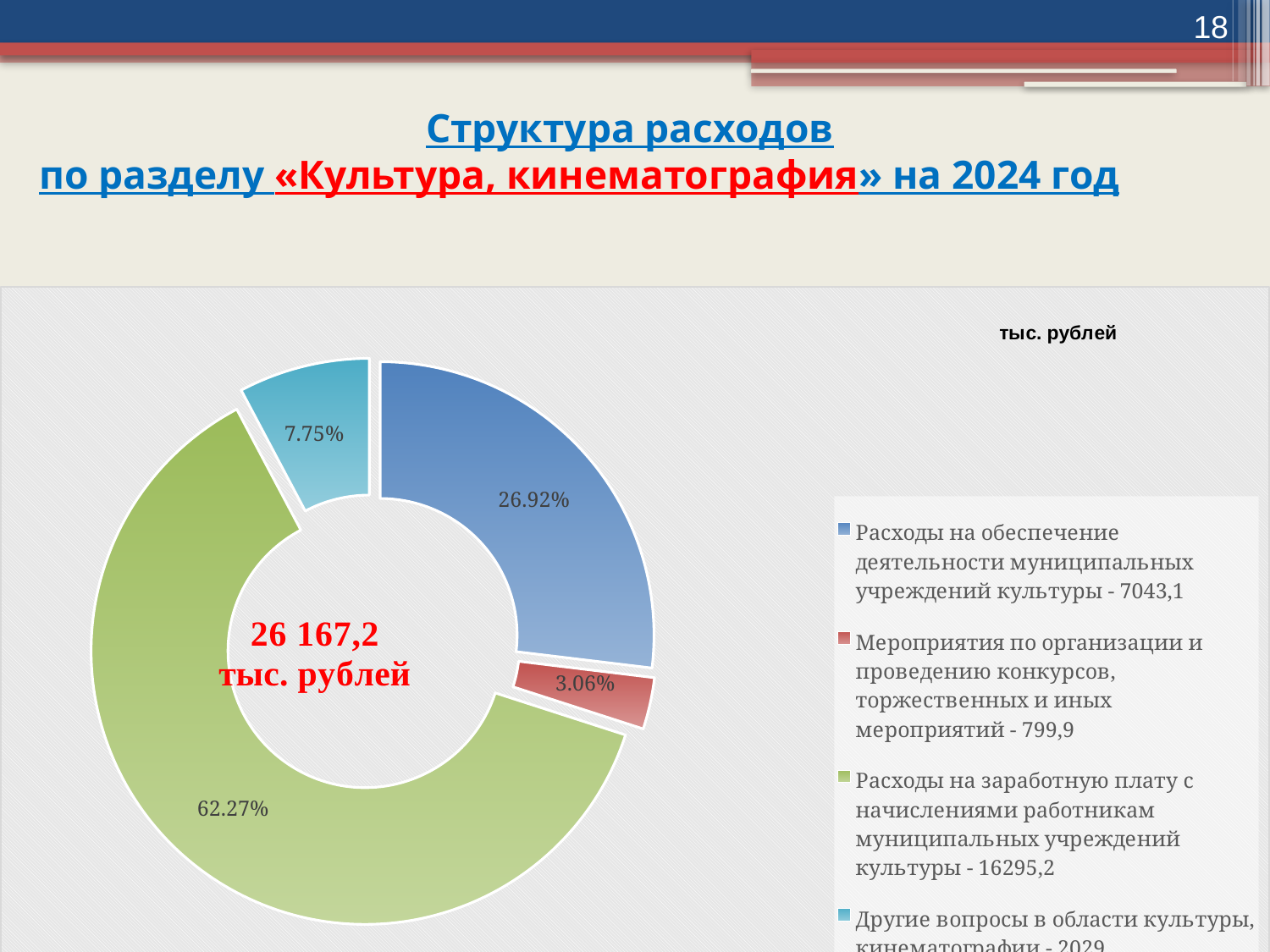
How many slices does the doughnut chart have? 4 What kind of chart is shown on the slide? Doughnut (pie) chart What share of expenses goes to 'Мероприятия по организации и проведению конкурсов, торжественных и иных мероприятий'? 3.06% What share of expenses goes to 'Расходы на обеспечение деятельности муниципальных учреждений культуры'? 26.92% Which category has the largest share of expenses? Расходы на заработную плату с начислениями работникам муниципальных учреждений культуры What share of expenses goes to 'Расходы на заработную плату с начислениями работникам муниципальных учреждений культуры'? 62.27% What is the amount (тыс. рублей) for 'Расходы на заработную плату с начислениями работникам муниципальных учреждений культуры'? 16295,2 What is the total amount of expenses shown in the centre of the chart? 26 167,2 тыс. рублей What is the difference in percentage points between the salary slice (62.27%) and the institutions' operations slice (26.92%)? 35.35% Which category has the smallest share of expenses? Мероприятия по организации и проведению конкурсов, торжественных и иных мероприятий What is the amount (тыс. рублей) for 'Расходы на обеспечение деятельности муниципальных учреждений культуры'? 7043,1